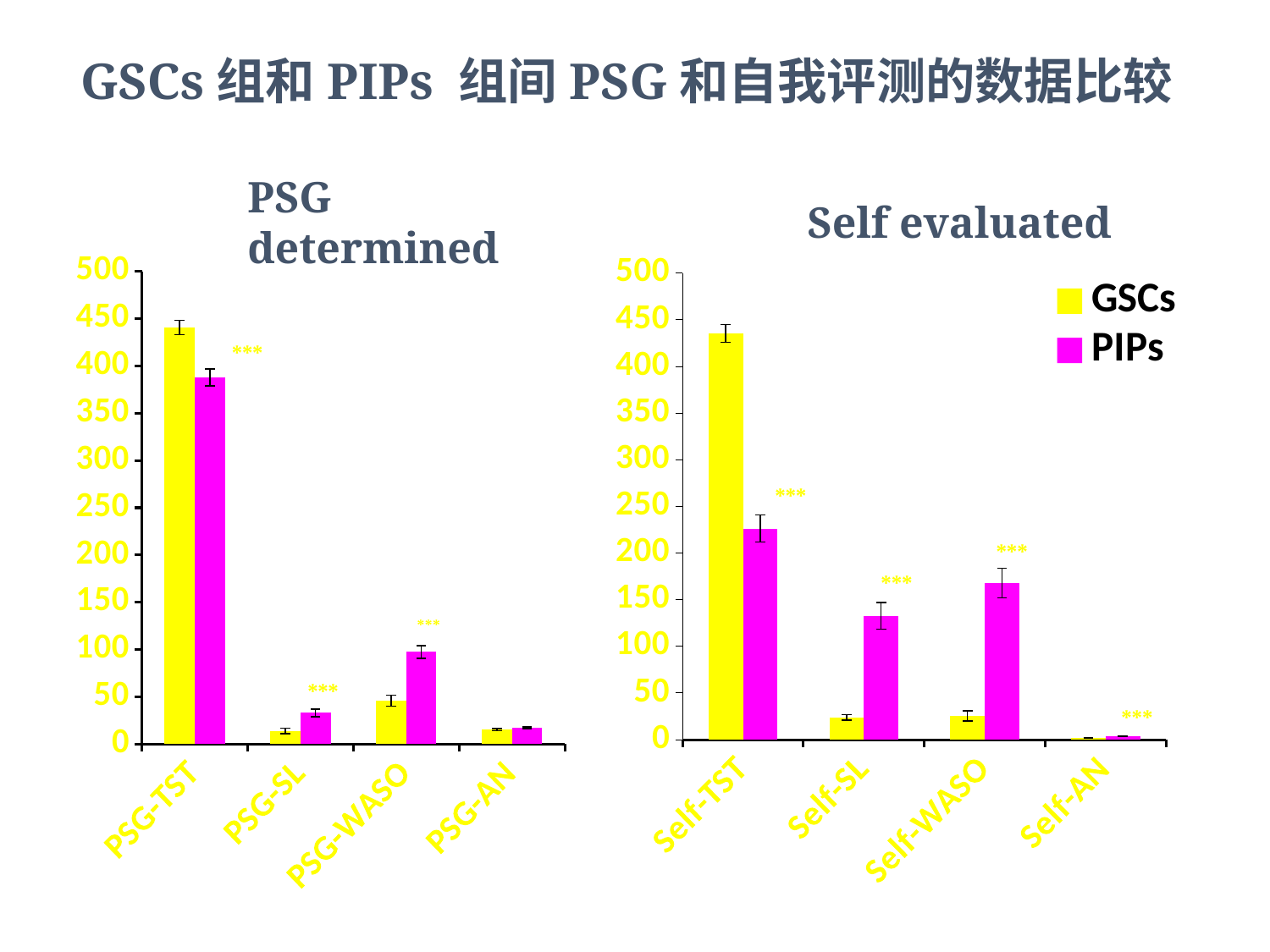
How many series does the legend on the slide list? 2 In the 'Self evaluated' chart, which series has the larger value for Self-TST, GSCs or PIPs? GSCs What colour represents the PIPs series in the legend? magenta In the 'PSG determined' chart, which category has the lowest PIPs value? PSG-AN In the 'Self evaluated' chart, is the PIPs value for Self-WASO greater or less than 150? greater In the 'PSG determined' chart, is the PIPs value for PSG-WASO greater or less than 50? greater In the 'Self evaluated' chart, is the PIPs value for Self-TST greater or less than 250? less In the 'Self evaluated' chart, which category has the highest PIPs value? Self-TST In the 'PSG determined' chart, which series has the larger value for PSG-WASO, GSCs or PIPs? PIPs How many categories are shown on the x axis of the 'PSG determined' chart? 4 What kind of chart is the 'PSG determined' chart on the left? bar chart